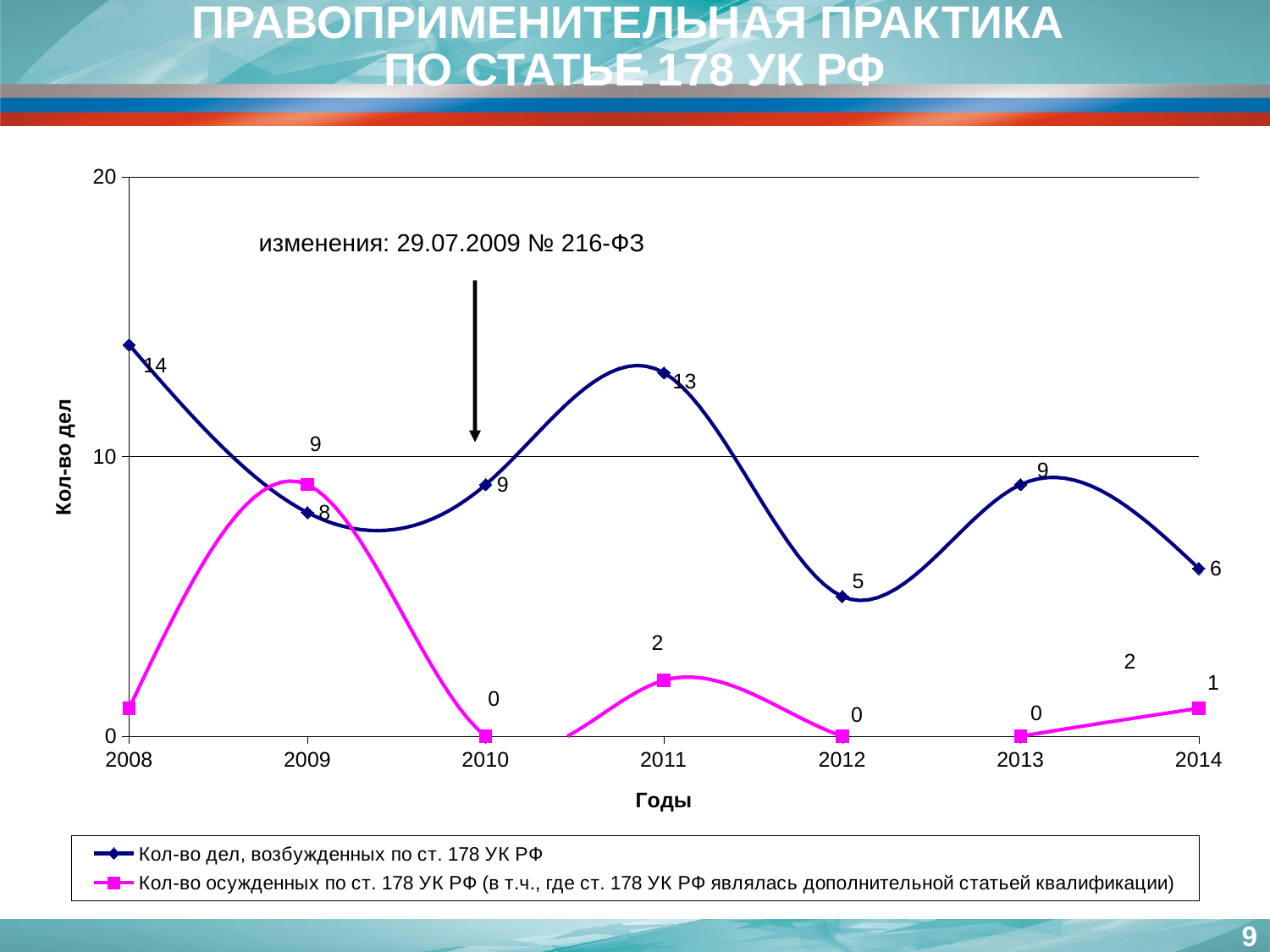
What is the number of cases initiated under Art. 178 in 2012? 5 What is the number of convicted persons under Art. 178 in 2011? 2 What is the label of the x axis? Годы In which year is the number of cases initiated under Art. 178 lowest? 2012 Which is larger: the number of cases initiated in 2013 or in 2014? 2013 What is the number of convicted persons (Кол-во осужденных по ст. 178 УК РФ) in 2009? 9 What kind of chart is shown on the slide? line chart How many series does the legend list? 2 What is the difference between the number of cases initiated in 2011 and in 2012? 8 How many years are shown on the x axis? 7 In which year is the number of cases initiated under Art. 178 highest? 2008 What is the number of cases initiated under Art. 178 (Кол-во дел, возбужденных по ст. 178 УК РФ) in 2008? 14